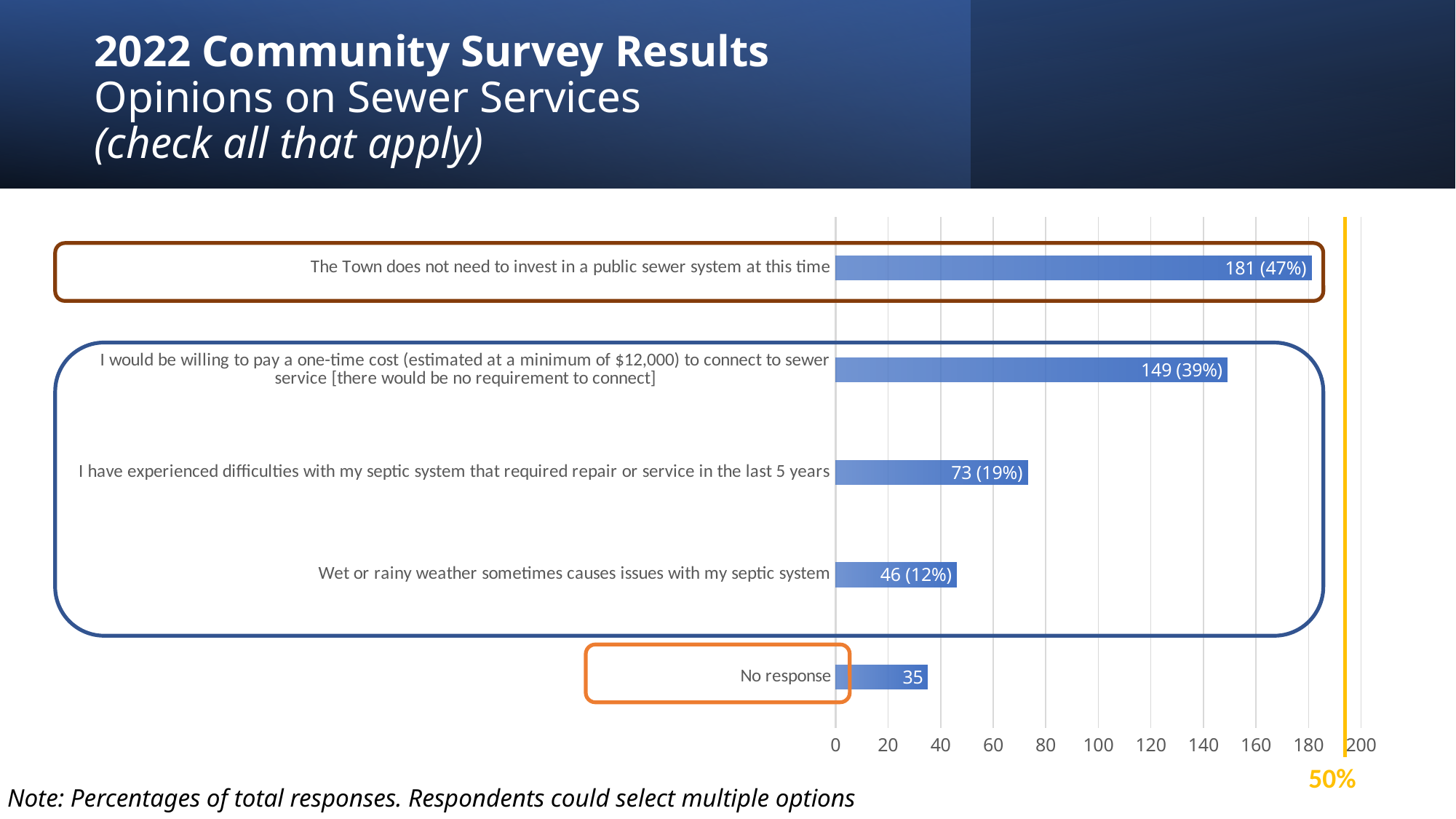
What percentage is labelled next to the yellow vertical line on the right of the chart? 50% What is the value shown for "No response"? 35 What is the difference in count between "The Town does not need to invest in a public sewer system at this time" and "I would be willing to pay a one-time cost (estimated at a minimum of $12,000) to connect to sewer service"? 32 What is the value shown for "Wet or rainy weather sometimes causes issues with my septic system"? 46 (12%) What is the value shown for "I have experienced difficulties with my septic system that required repair or service in the last 5 years"? 73 (19%) What is the value shown for "The Town does not need to invest in a public sewer system at this time"? 181 (47%) Which category has the highest value? The Town does not need to invest in a public sewer system at this time Which category has the lowest value? No response How many categories are shown in the chart? 5 What kind of chart is shown on the slide? Bar chart What is the maximum value shown on the horizontal axis? 200 Which is larger: the count for "I have experienced difficulties with my septic system that required repair or service in the last 5 years" or for "Wet or rainy weather sometimes causes issues with my septic system"? I have experienced difficulties with my septic system that required repair or service in the last 5 years